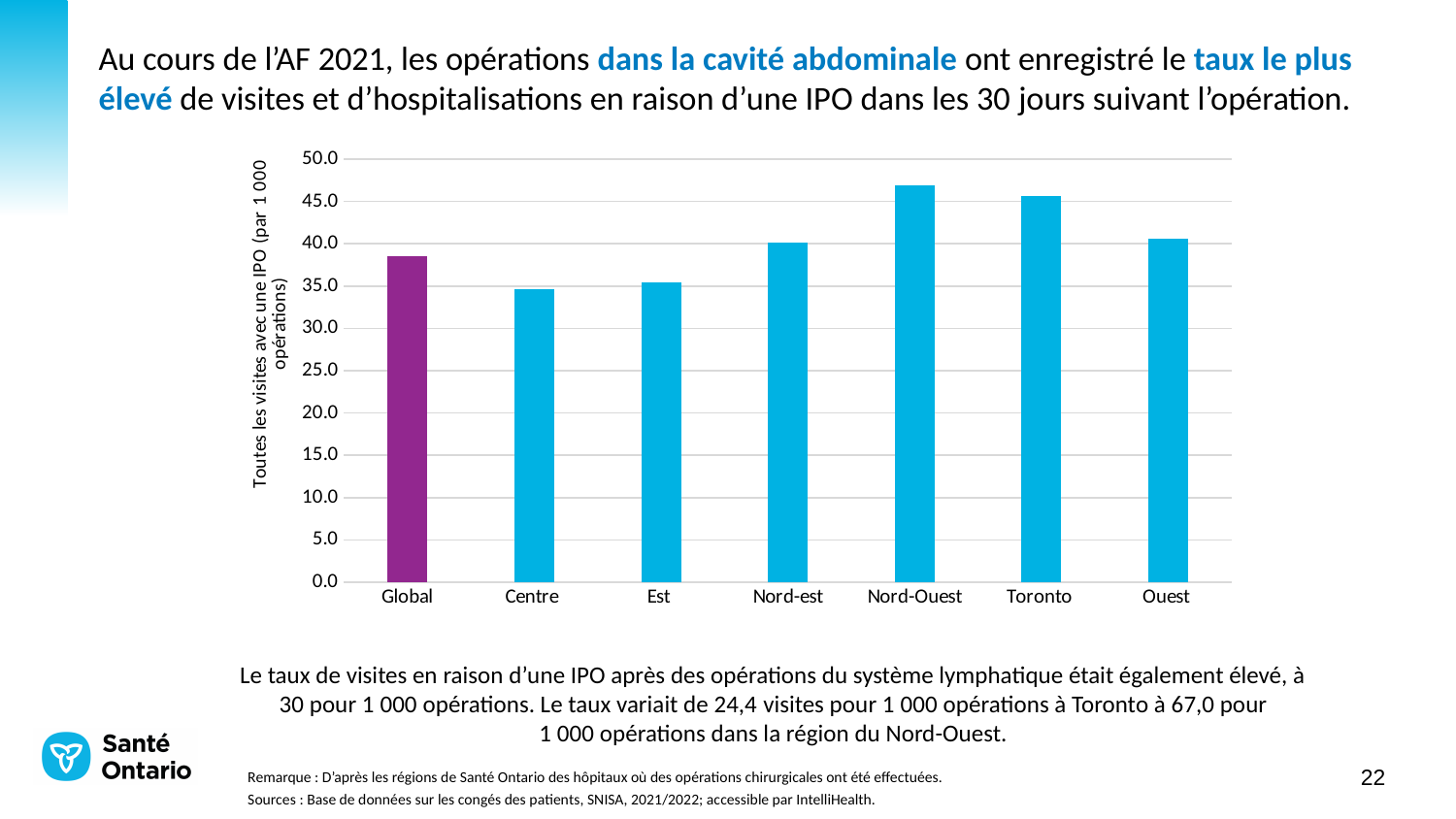
Is the value for Nord-Ouest greater or less than 45.0? greater Which is larger, the value for Toronto or the value for Centre? Toronto Which bar in the chart is coloured differently (purple) from the others? Global Is the value for Toronto greater or less than 40.0? greater Is the value for Est greater or less than 40.0? less Which region has the highest rate of visits with an IPO in the chart? Nord-Ouest What kind of chart is shown on the slide? bar chart How many categories are shown on the x axis of the chart? 7